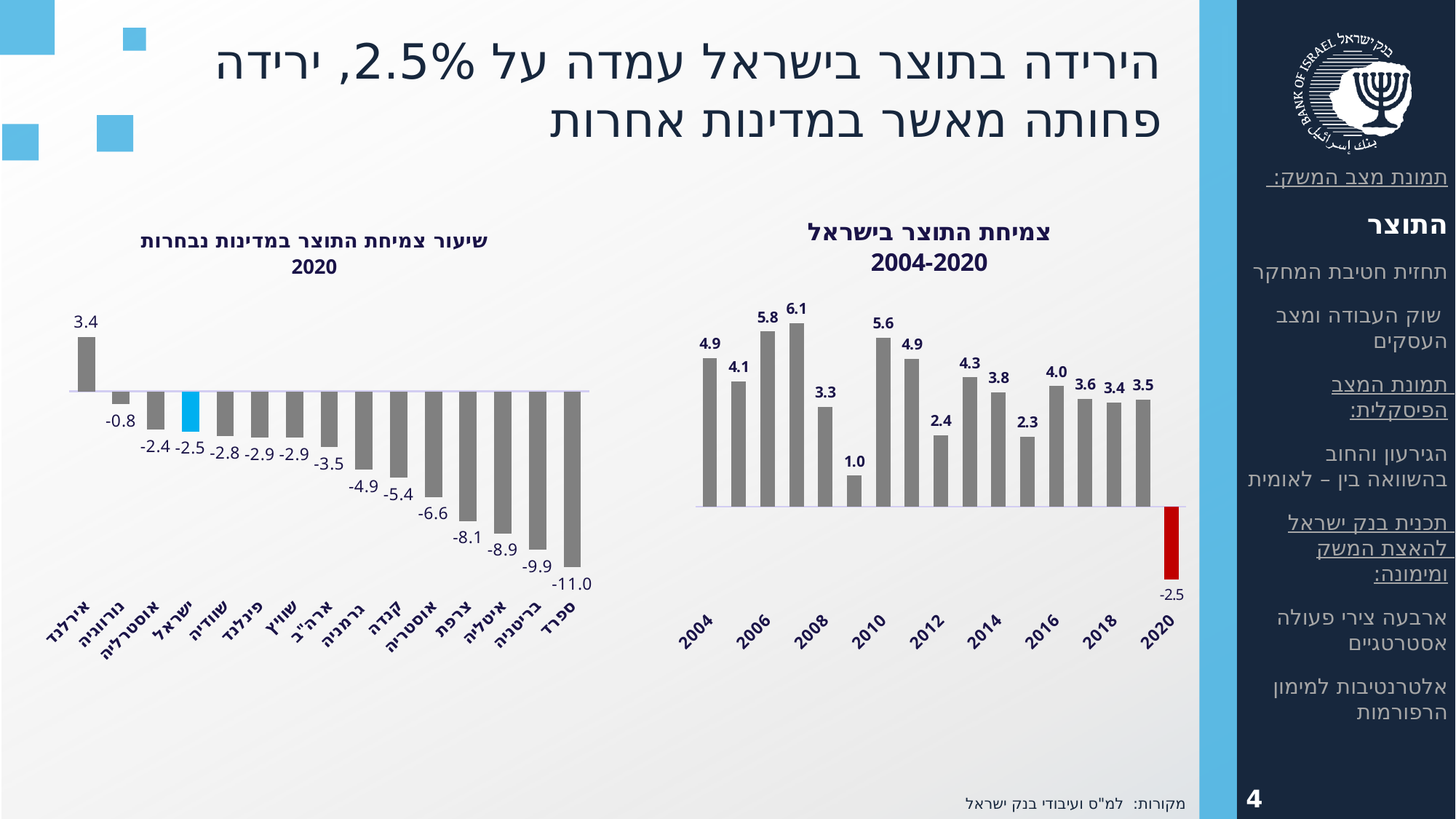
In the left chart (שיעור צמיחת התוצר במדינות נבחרות 2020), which country has the highest value? אירלנד In the left chart (שיעור צמיחת התוצר במדינות נבחרות 2020), how many countries are shown? 15 In the left chart (שיעור צמיחת התוצר במדינות נבחרות 2020), what is the value for ישראל? -2.5 In the right chart (צמיחת התוצר בישראל 2004-2020), what is the value for 2009? 1.0 In the left chart (שיעור צמיחת התוצר במדינות נבחרות 2020), what is the value for ספרד? -11.0 In the left chart (שיעור צמיחת התוצר במדינות נבחרות 2020), which country has the lowest value? ספרד What type of chart is the left chart (שיעור צמיחת התוצר במדינות נבחרות 2020)? Bar chart In the right chart (צמיחת התוצר בישראל 2004-2020), what is the value for 2020? -2.5 In the right chart (צמיחת התוצר בישראל 2004-2020), how many bars are plotted? 17 In the right chart (צמיחת התוצר בישראל 2004-2020), which is larger, the value for 2006 or the value for 2016? 2006 In the right chart (צמיחת התוצר בישראל 2004-2020), which year has the highest value? 2007 In the right chart (צמיחת התוצר בישראל 2004-2020), what is the difference between the values for 2010 and 2012? 3.2